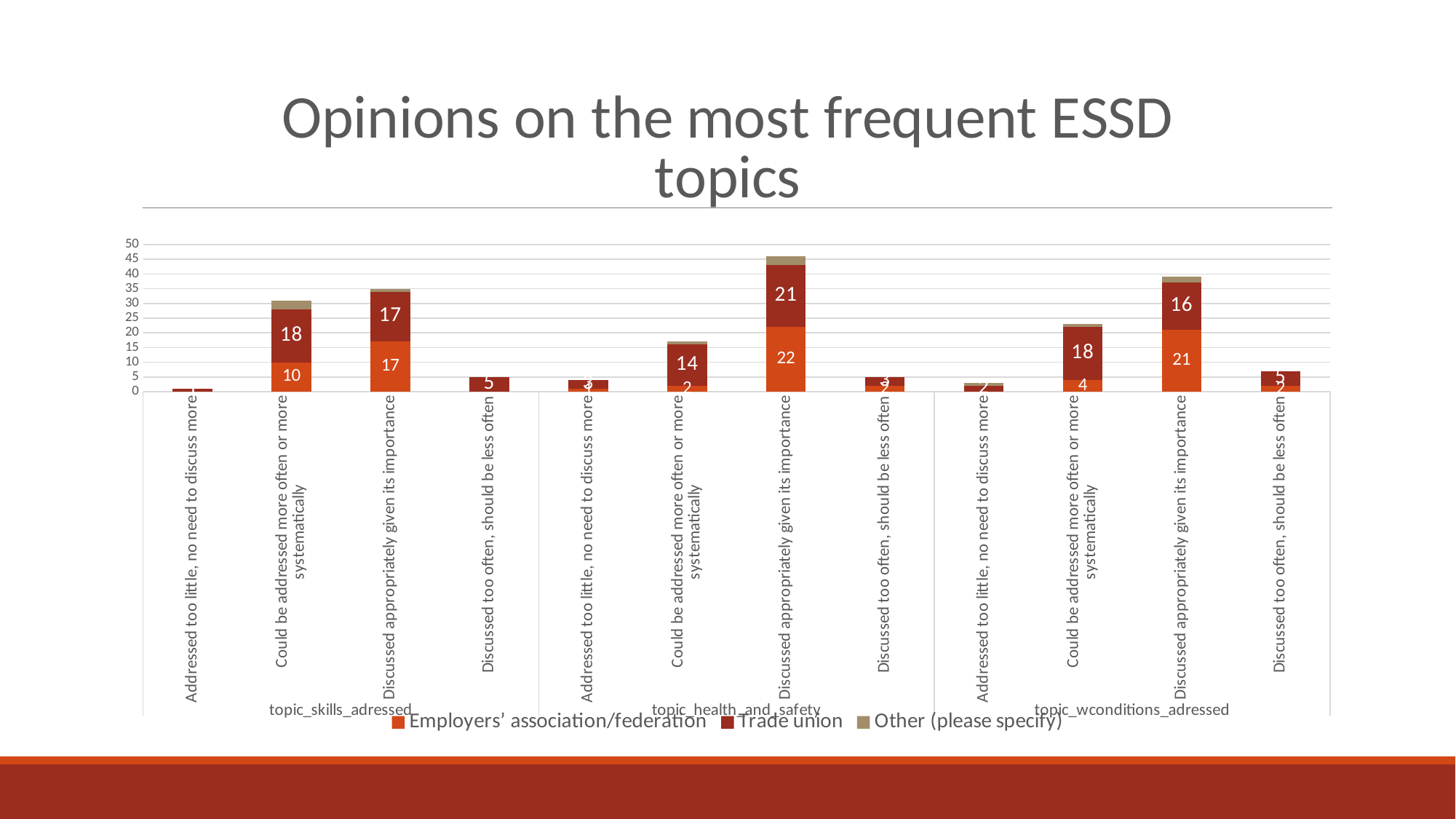
Under topic_skills_adressed, how much larger is the Trade union value than the Employers' association/federation value for "Could be addressed more often or more systematically"? 8 Under topic_wconditions_adressed, for "Discussed appropriately given its importance", which is larger: the Employers' association/federation value or the Trade union value? Employers' association/federation What is the Trade union value for "Could be addressed more often or more systematically" under topic_skills_adressed? 18 Which bar is the tallest stacked bar on the chart? Discussed appropriately given its importance (topic_health_and_safety) How many series does the legend list? 3 What is the Employers' association/federation value for "Discussed appropriately given its importance" under topic_health_and_safety? 22 How many stacked bars are plotted on the chart in total? 12 What is the title of the chart? Opinions on the most frequent ESSD topics What is the Trade union value for "Discussed appropriately given its importance" under topic_wconditions_adressed? 16 What is the Trade union value for "Could be addressed more often or more systematically" under topic_health_and_safety? 14 Is the total stacked bar for "Discussed appropriately given its importance" under topic_health_and_safety greater or less than 40? greater What kind of chart is shown on the slide? bar chart